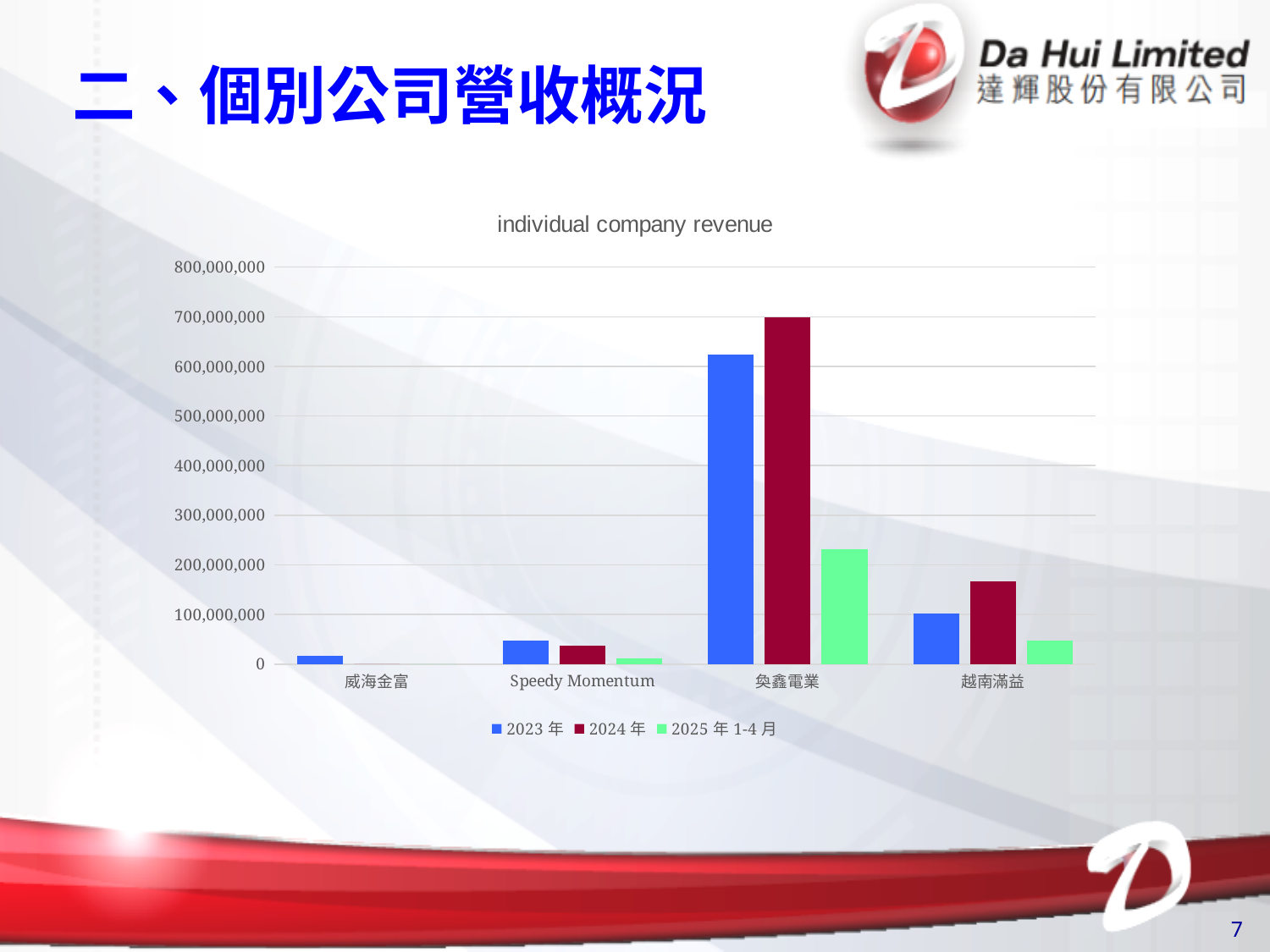
How many companies are shown on the x axis of the chart? 4 Which company has the lowest 2023 年 revenue? 威海金富 Is the 2023 年 revenue for 奐鑫電業 greater or less than 500,000,000? greater Which series are listed in the chart's legend? 2023 年, 2024 年, 2025 年 1-4 月 Which company has the highest 2024 年 revenue? 奐鑫電業 How many series does the chart's legend list? 3 For 奐鑫電業, which is larger: the 2023 年 revenue or the 2024 年 revenue? 2024 年 Is the 2025 年 1-4 月 revenue for 奐鑫電業 greater or less than 200,000,000? greater What kind of chart is shown on the slide? bar chart Is the 2024 年 revenue for 越南滿益 greater or less than 200,000,000? less For 越南滿益, which is larger: the 2023 年 revenue or the 2024 年 revenue? 2024 年 What is the title of the chart? individual company revenue